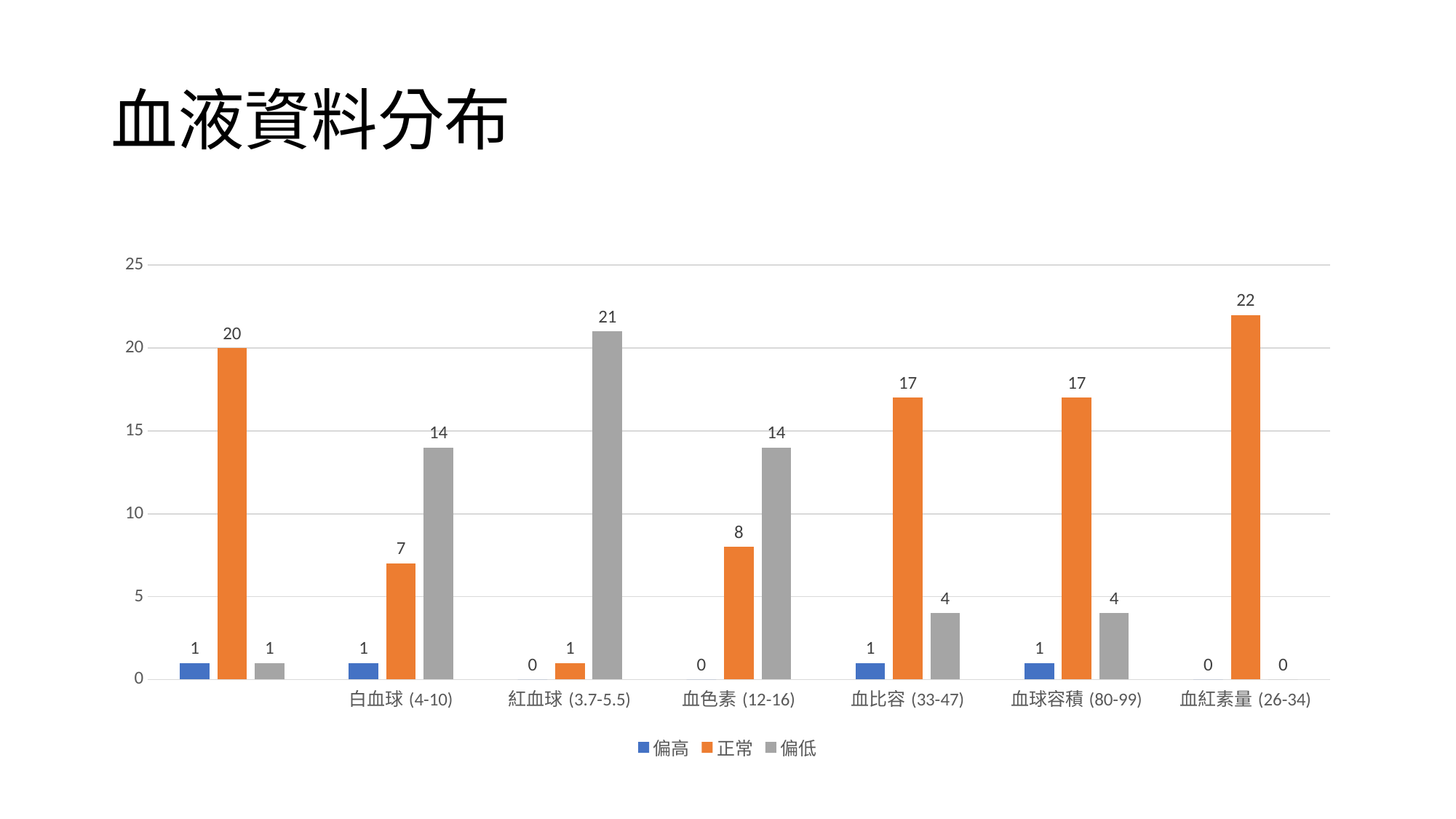
Which labeled category has the lowest 偏低 value? 血紅素量 (26-34) What is the 正常 value for 白血球 (4-10)? 7 Which category has the highest 正常 value? 血紅素量 (26-34) What kind of chart is shown on the slide? Bar chart What is the 正常 value for 血紅素量 (26-34)? 22 What is the difference between the 偏低 and 正常 values for 血色素 (12-16)? 6 How many series does the legend list? 3 Is the 偏低 value for 紅血球 (3.7-5.5) greater or less than 20? greater What is the sum of the 偏高, 正常 and 偏低 values for 血球容積 (80-99)? 22 What is the 偏低 value for 紅血球 (3.7-5.5)? 21 What is the 偏高 value for 血比容 (33-47)? 1 For 血比容 (33-47), which is larger: the 正常 value or the 偏低 value? 正常